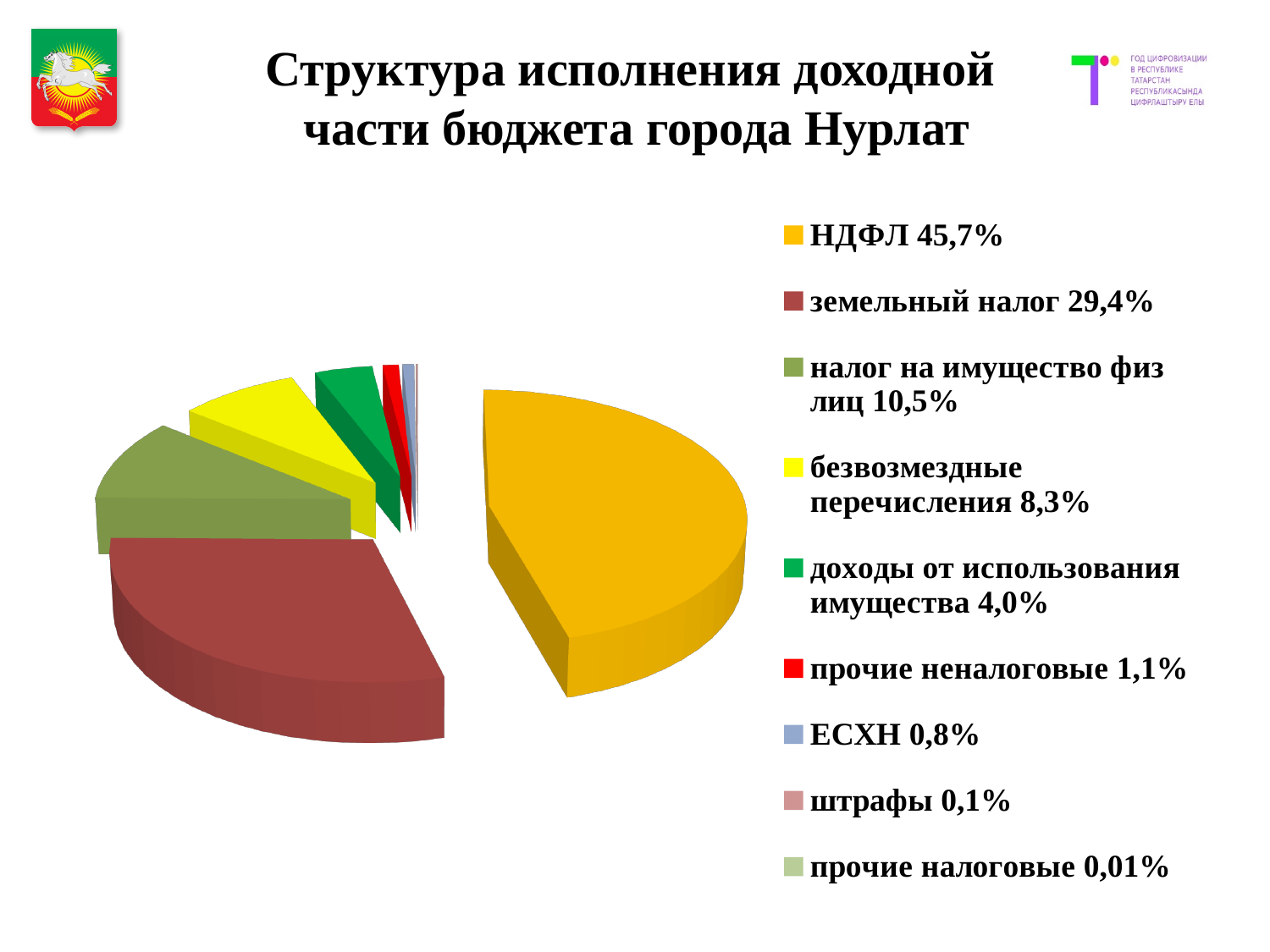
What is the title of the chart on the slide? Структура исполнения доходной части бюджета города Нурлат What is the difference between the shares of НДФЛ and земельный налог? 16,3% Which is larger: налог на имущество физ лиц or безвозмездные перечисления? налог на имущество физ лиц What colour is the slice for доходы от использования имущества? green What is the value for ЕСХН? 0,8% What percentage is shown for безвозмездные перечисления? 8,3% Which category has the largest share of the pie? НДФЛ What kind of chart is shown on the slide? pie chart What is the value shown for земельный налог? 29,4% What share of the budget revenue does НДФЛ account for? 45,7% Which category has the smallest share of the pie? прочие налоговые How many categories does the pie chart have? 9